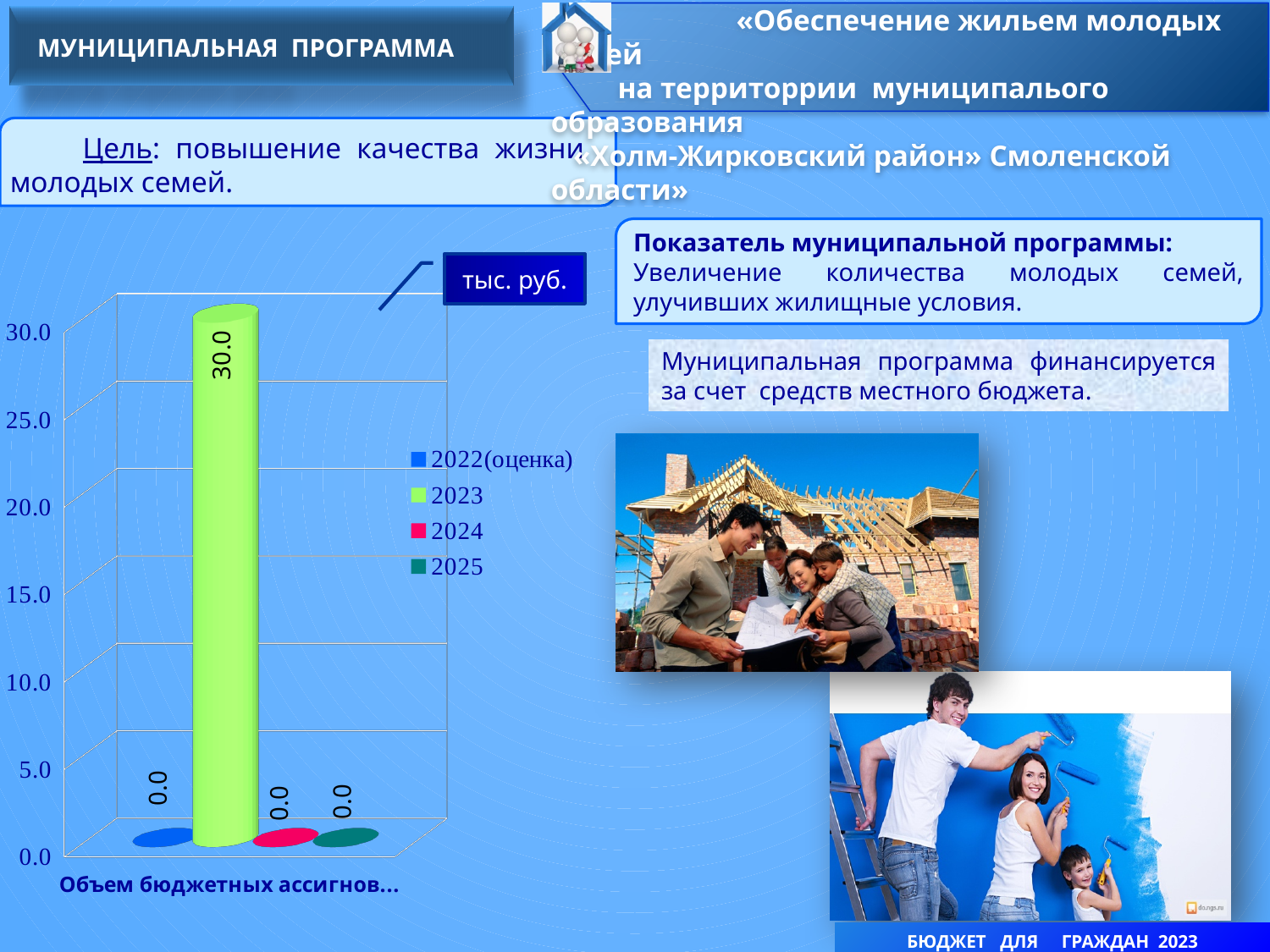
What is the value for 2025 in the chart? 0.0 How many series does the chart legend list? 4 What kind of chart is shown on the slide? bar chart What colour is the bar for 2023 in the chart? green Which is larger, the value for 2023 or the value for 2025? 2023 Is the value for 2023 greater or less than 25.0? greater What is the value for 2024 in the chart? 0.0 What is the difference between the values for 2023 and 2024? 30.0 Which series has the highest value in the chart? 2023 What is the value for 2022(оценка) in the chart? 0.0 What unit of measurement is indicated for the chart? тыс. руб. What is the value for 2023 in the chart? 30.0